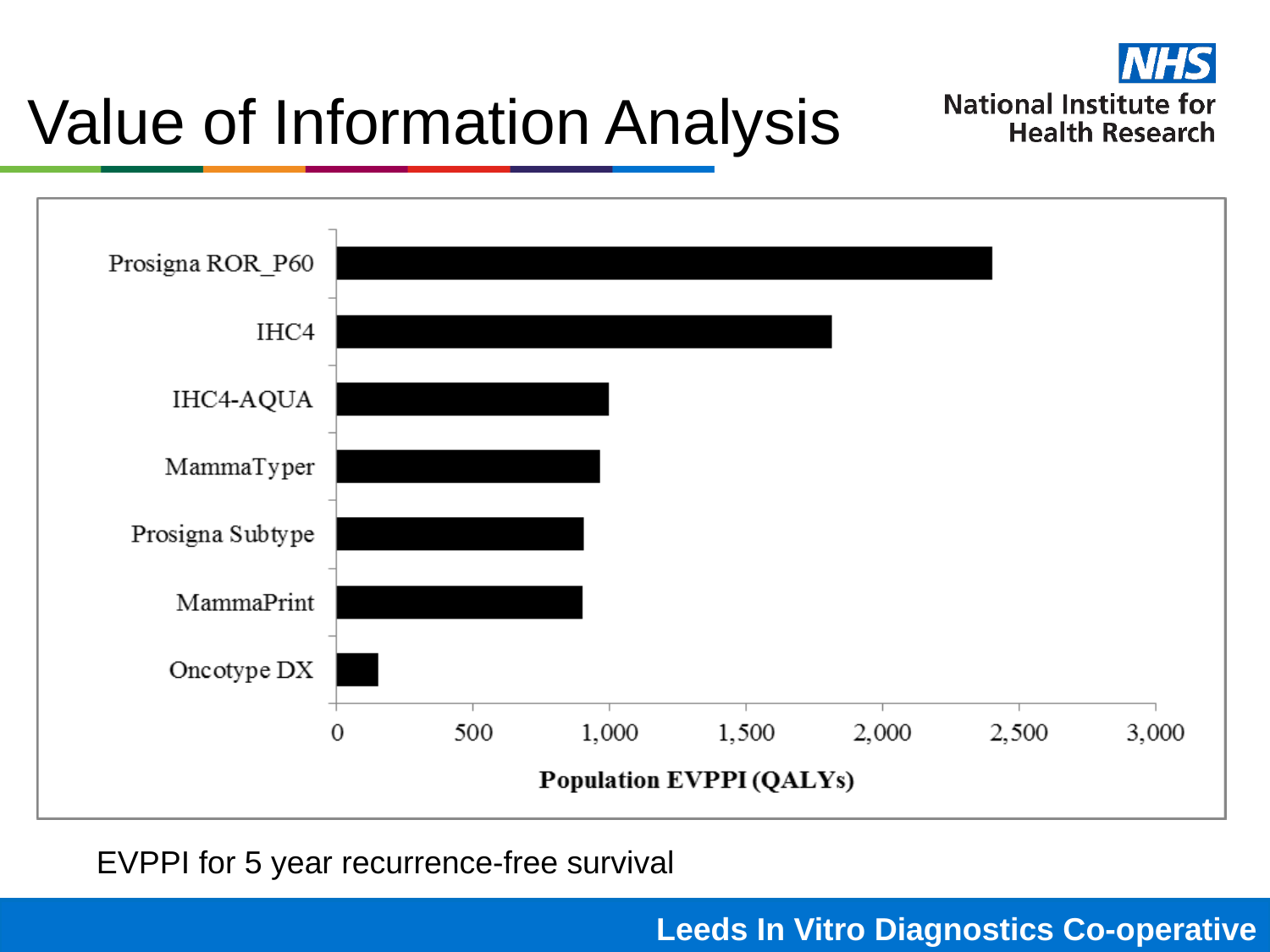
Which test has the highest Population EVPPI? Prosigna ROR_P60 What kind of chart is shown on the slide? bar chart How many tests (categories) are plotted in the chart? 7 Is the Population EVPPI for IHC4 greater or less than 1,500? greater Which test has the lowest Population EVPPI? Oncotype DX Which has a larger Population EVPPI, IHC4 or IHC4-AQUA? IHC4 Is the Population EVPPI for Prosigna ROR_P60 greater or less than 2,000? greater Is the Population EVPPI for IHC4 greater or less than 2,000? less Which has a larger Population EVPPI, Prosigna Subtype or Oncotype DX? Prosigna Subtype What is the label of the horizontal axis of the chart? Population EVPPI (QALYs)